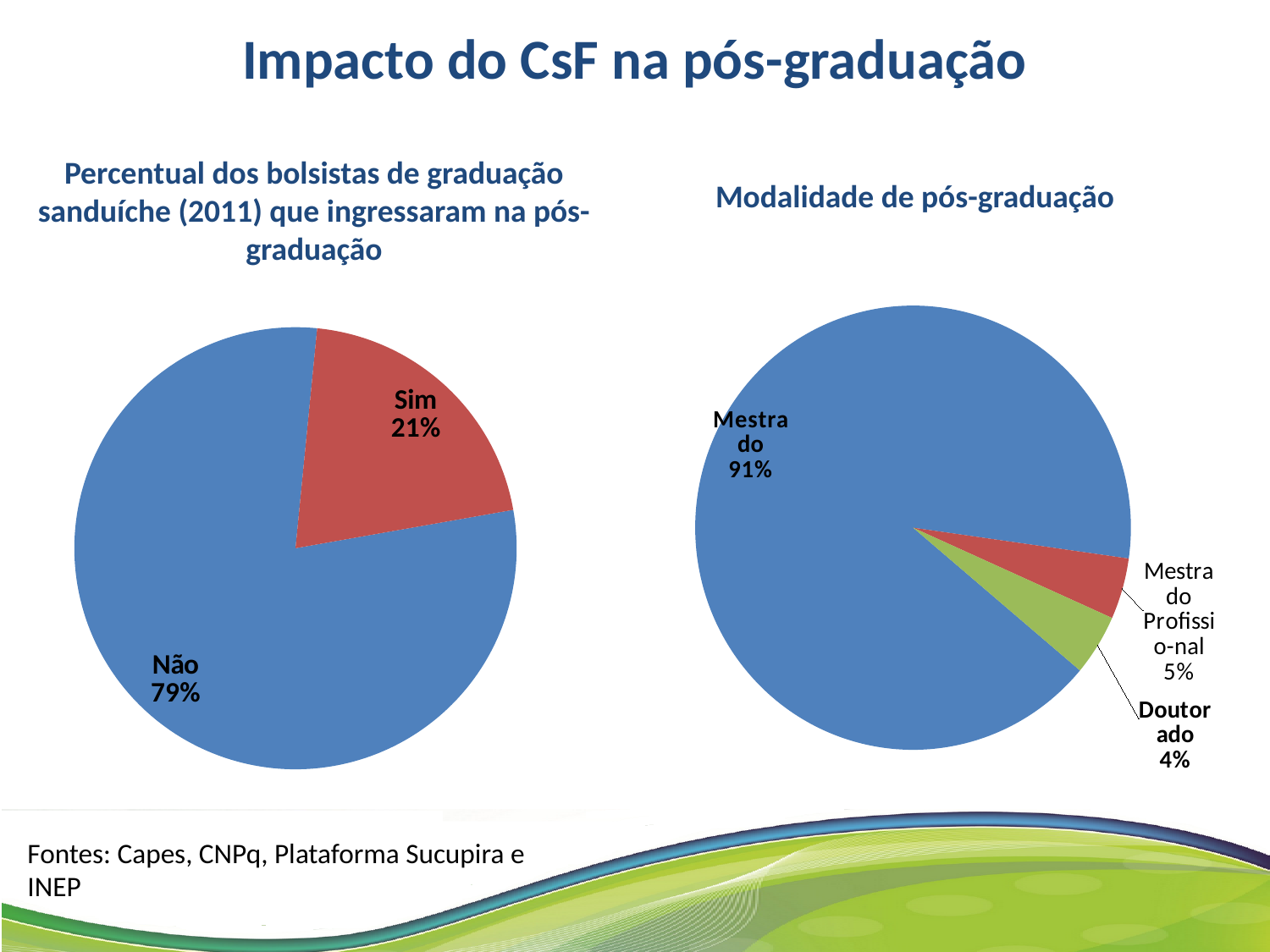
In the right pie chart (Modalidade de pós-graduação), what share is labelled 'Doutorado'? 4% In the right pie chart (Modalidade de pós-graduação), what share is labelled 'Mestrado'? 91% What kind of chart is used on the right side of the slide (Modalidade de pós-graduação)? Pie chart In the left pie chart (Percentual dos bolsistas de graduação sanduíche (2011) que ingressaram na pós-graduação), what share is labelled 'Não'? 79% In the left pie chart (Percentual dos bolsistas de graduação sanduíche (2011) que ingressaram na pós-graduação), how many slices are there? 2 In the left pie chart (Percentual dos bolsistas de graduação sanduíche (2011) que ingressaram na pós-graduação), what share is labelled 'Sim'? 21% In the left pie chart (Percentual dos bolsistas de graduação sanduíche (2011) que ingressaram na pós-graduação), what is the difference between the 'Não' and 'Sim' shares? 58% In the left pie chart (Percentual dos bolsistas de graduação sanduíche (2011) que ingressaram na pós-graduação), which slice is the largest? Não In the right pie chart (Modalidade de pós-graduação), what colour is the 'Mestrado' slice? Blue In the right pie chart (Modalidade de pós-graduação), how many slices are there? 3 In the right pie chart (Modalidade de pós-graduação), what share is labelled 'Mestrado Profissional'? 5%